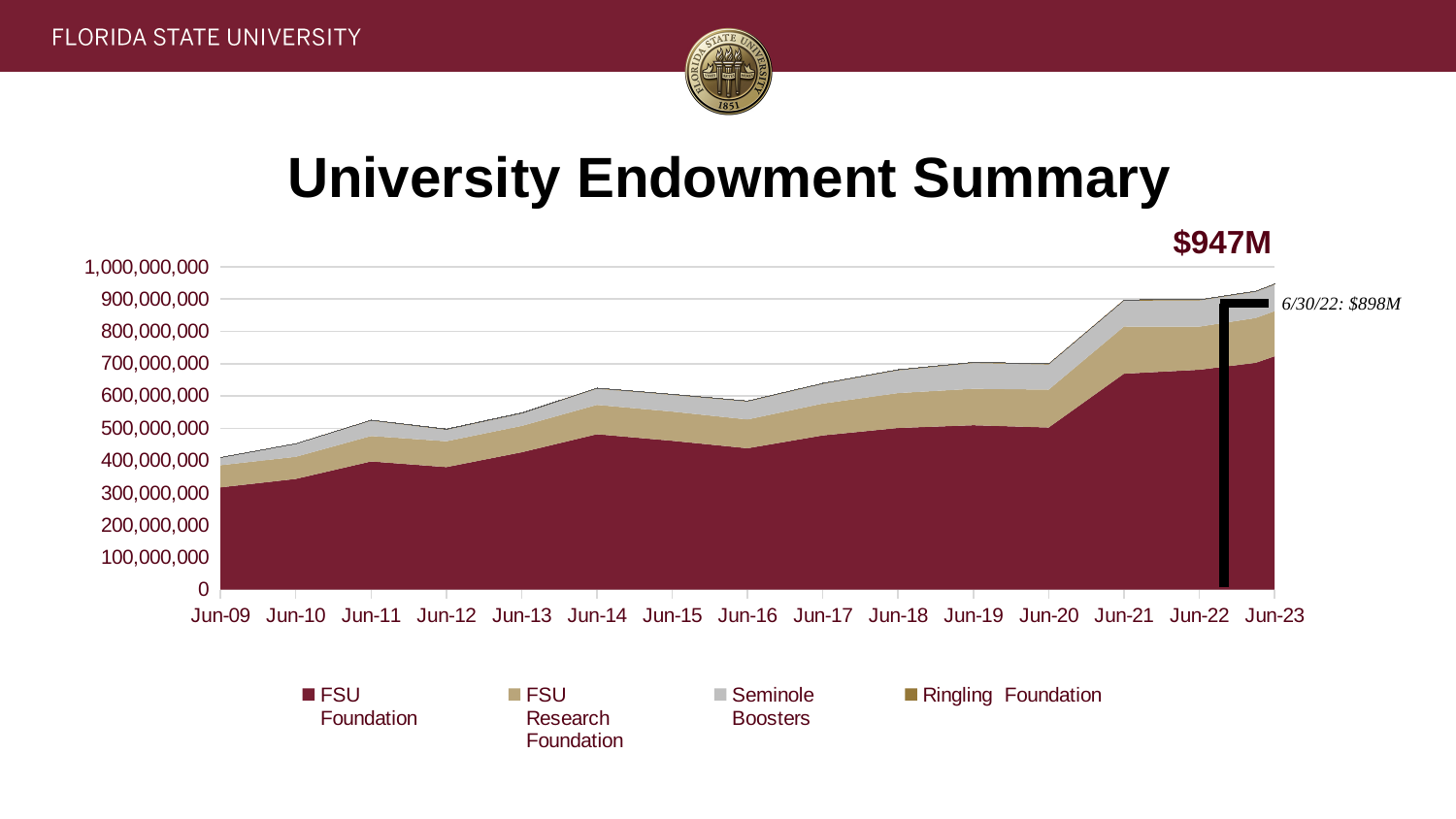
How many dates are shown along the x axis? 15 Which date has the highest total endowment? Jun-23 Which date has the lowest total endowment? Jun-09 What is the difference between the Jun-23 total ($947M) and the 6/30/22 value ($898M)? $49M Is the FSU Foundation value for Jun-09 greater or less than 400,000,000? less What kind of chart is shown on the slide? Stacked area chart What is the title of the chart? University Endowment Summary What endowment value is given for 6/30/22? $898M Is the FSU Foundation value for Jun-16 greater or less than 500,000,000? less What total endowment value is labelled for Jun-23? $947M How many series does the legend list? 4 Does the total endowment generally rise or fall from Jun-09 to Jun-23? Rise